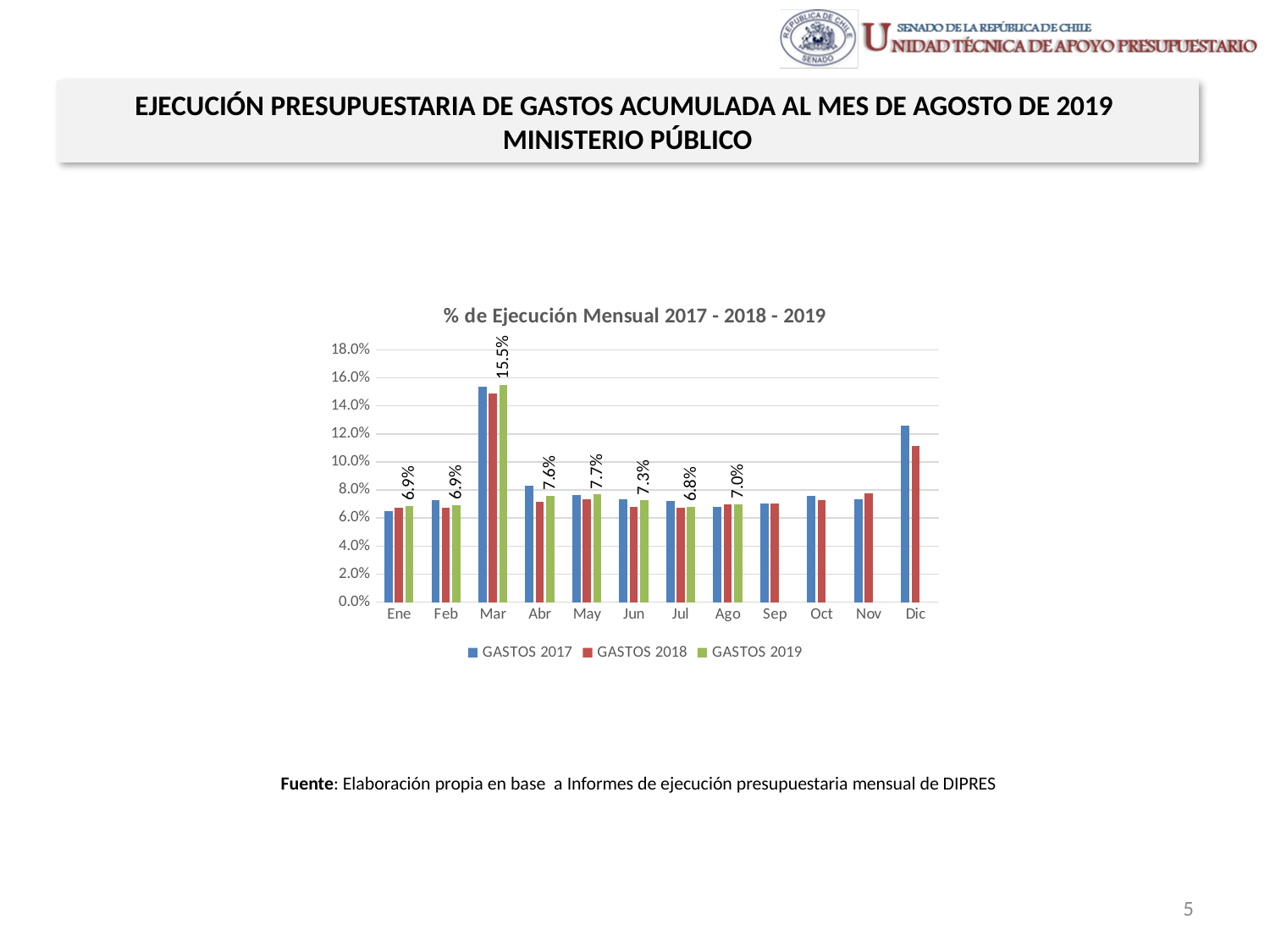
In which month is the GASTOS 2019 value highest? Mar How many months are shown on the x axis? 12 What kind of chart is shown on the slide? Bar chart What is the value for GASTOS 2019 in Abr? 7.6% How many series does the legend list? 3 In which month is the GASTOS 2019 value lowest? Jul What is the difference between the GASTOS 2019 values for Mar and Ene? 8.6 percentage points Is the value for GASTOS 2017 in Dic greater or less than 12.0%? greater What is the value for GASTOS 2019 in Mar? 15.5% What is the value for GASTOS 2019 in Ago? 7.0% Is the value for GASTOS 2018 in Dic greater or less than 10.0%? greater Which is larger for GASTOS 2019: May or Jun? May